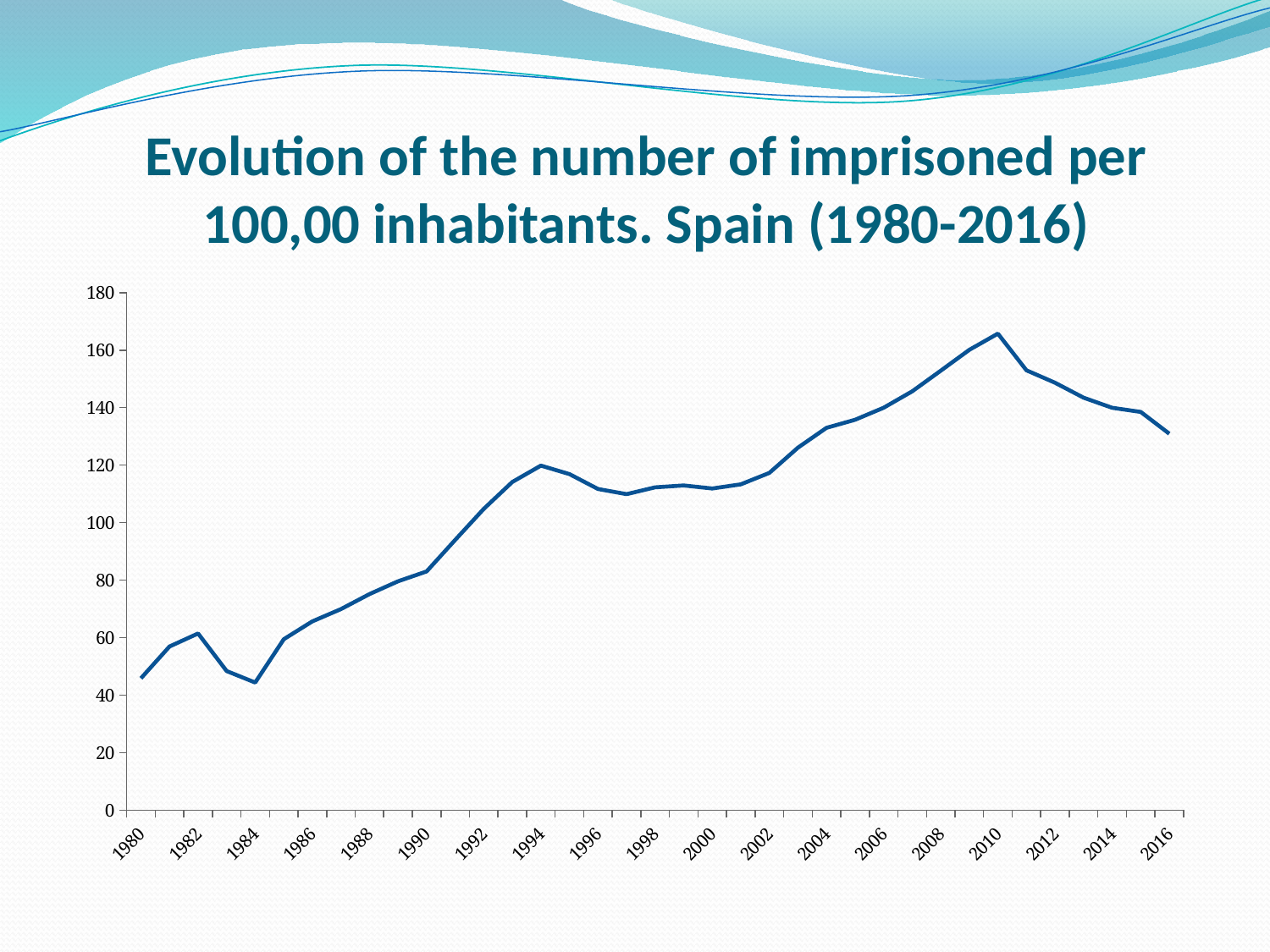
Which year has the larger value, 2010 or 2016? 2010 In which year does the line reach its highest value? 2010 Is the value for 2016 greater or less than 120? greater Is the value for 1994 greater or less than 100? greater Is the value for 1980 greater or less than 60? less What kind of chart is shown on the slide? line chart What is the title of the chart? Evolution of the number of imprisoned per 100,00 inhabitants. Spain (1980-2016) What is the highest value shown on the vertical axis? 180 Does the line rise or fall between 2010 and 2016? fall Which year has the larger value, 1984 or 1994? 1994